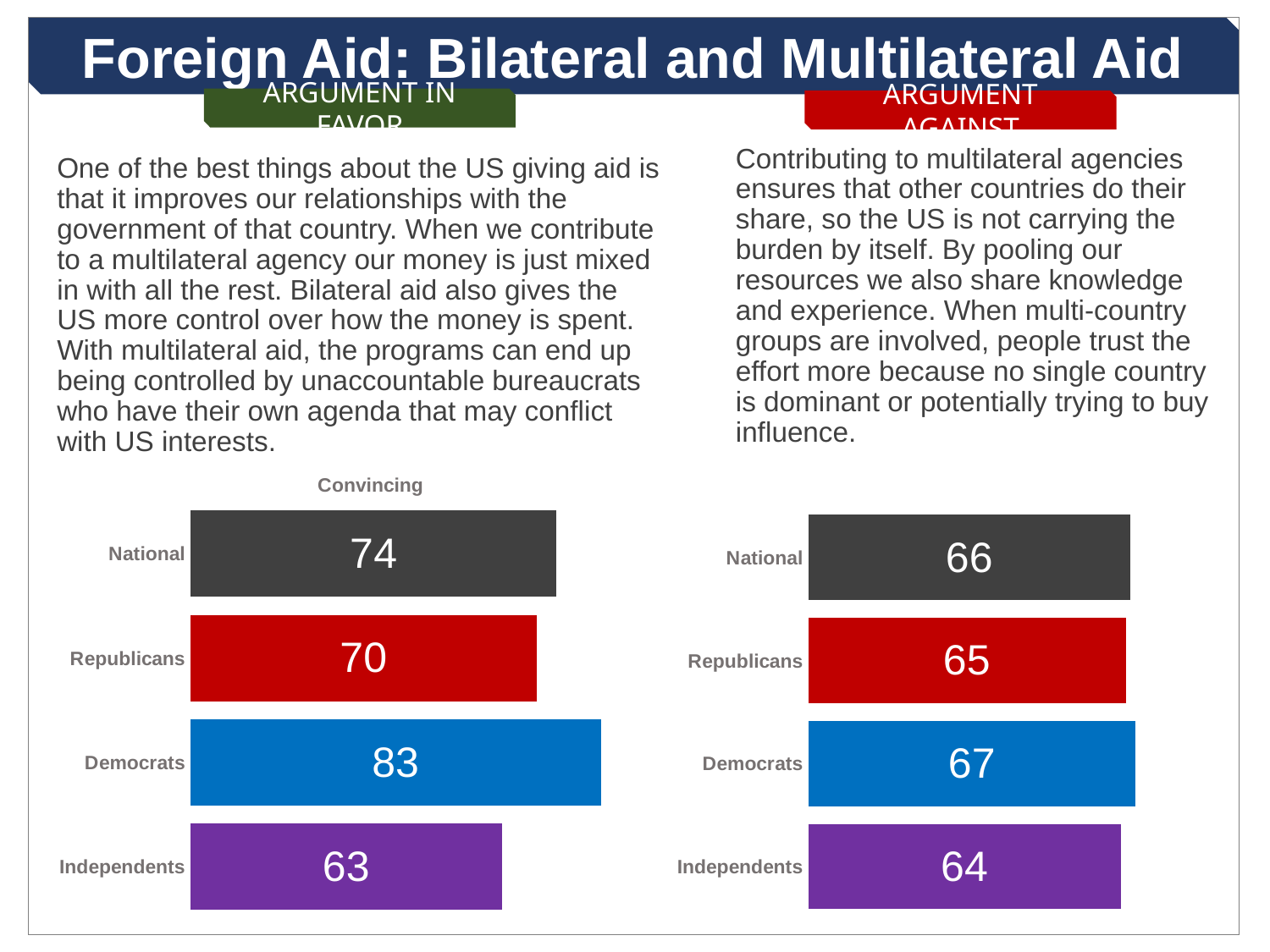
How many categories are shown in the right chart (Argument Against)? 4 In the left chart (Argument in Favor), which category has the highest value? Democrats In the left chart (Argument in Favor), what is the value for Democrats? 83 Which is larger: the National value in the left chart (Argument in Favor) or the National value in the right chart (Argument Against)? Left chart (Argument in Favor), 74 In the left chart (Argument in Favor), what is the difference between the values for Democrats and Republicans? 13 What type of chart is the left chart (Argument in Favor)? Bar chart In the left chart (Argument in Favor), which category has the lowest value? Independents What colour is the Democrats bar in the left chart (Argument in Favor)? Blue In the right chart (Argument Against), what is the value for Republicans? 65 In the right chart (Argument Against), what is the value for National? 66 In the left chart (Argument in Favor), what is the value for Independents? 63 In the right chart (Argument Against), which category has the lowest value? Independents